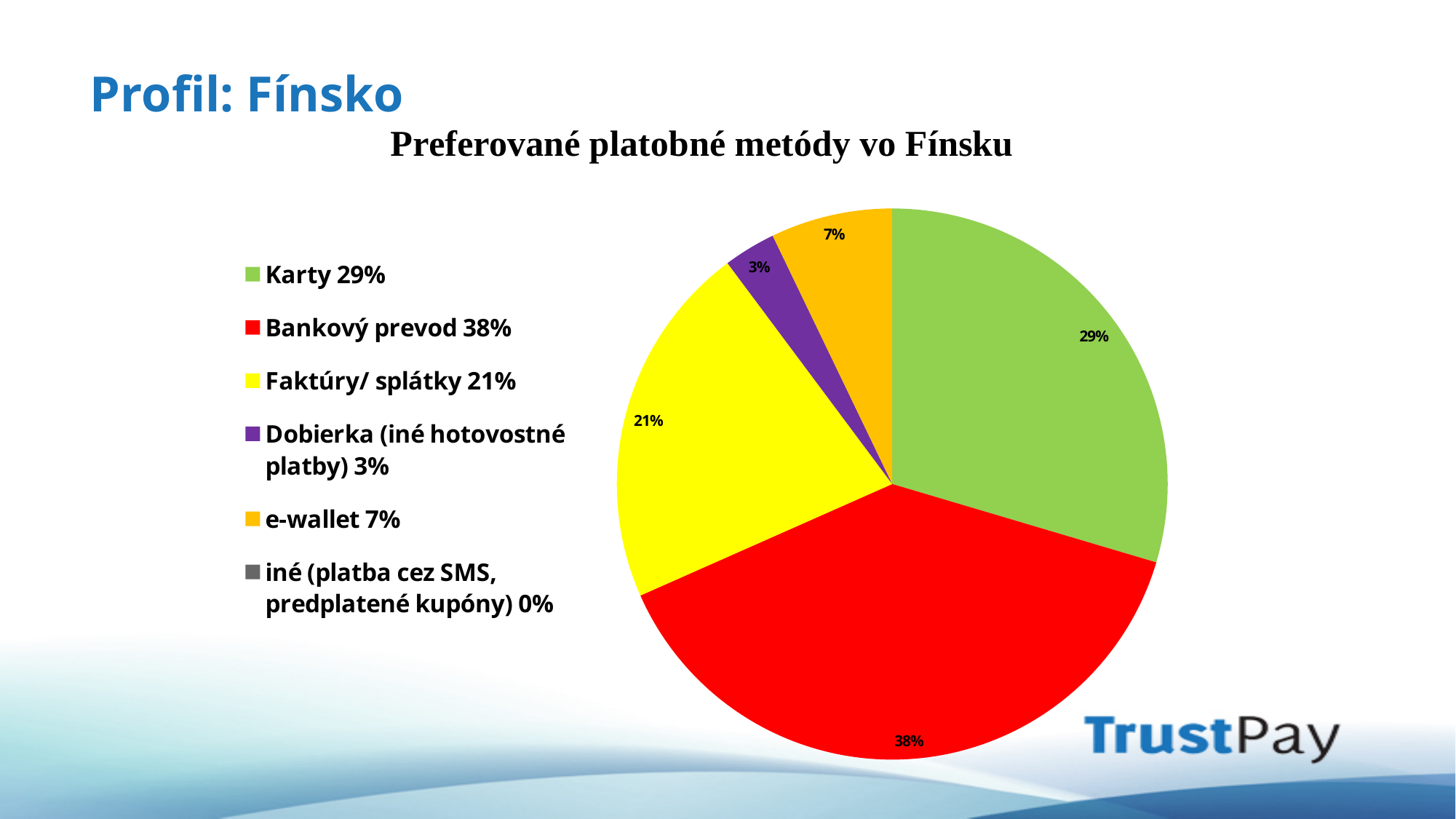
Which payment method has the smallest share of the pie? iné (platba cez SMS, predplatené kupóny) What share of the pie does Bankový prevod have? 38% Which is larger, the share of Faktúry/ splátky or the share of e-wallet? Faktúry/ splátky What share of the pie does e-wallet have? 7% What is the chart's title? Preferované platobné metódy vo Fínsku What is the difference between the shares of Bankový prevod and Karty? 9% What share of the pie does Dobierka (iné hotovostné platby) have? 3% Which payment method has the largest share of the pie? Bankový prevod How many categories does the legend list? 6 What type of chart is shown on the slide? pie chart What share of the pie does Faktúry/ splátky have? 21% What share of the pie does Karty have? 29%